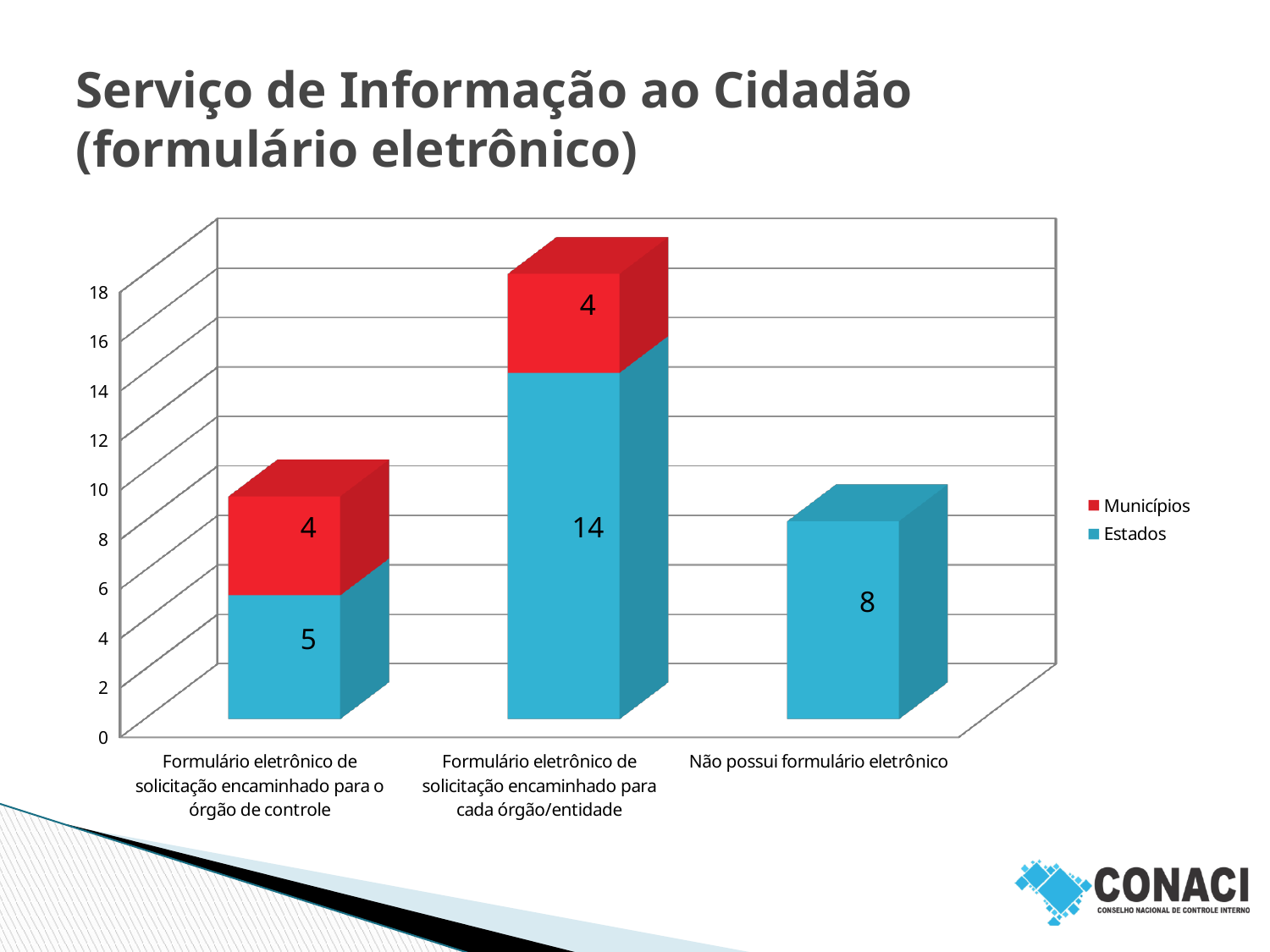
Which is larger: the Estados value for "Não possui formulário eletrônico" or the Estados value for "Formulário eletrônico de solicitação encaminhado para o órgão de controle"? Não possui formulário eletrônico What is the Estados value for "Formulário eletrônico de solicitação encaminhado para o órgão de controle"? 5 What is the total of the stacked bar for "Formulário eletrônico de solicitação encaminhado para o órgão de controle"? 9 Which category has the highest Estados value? Formulário eletrônico de solicitação encaminhado para cada órgão/entidade What is the Municípios value for "Formulário eletrônico de solicitação encaminhado para o órgão de controle"? 4 What is the total of the stacked bar for "Formulário eletrônico de solicitação encaminhado para cada órgão/entidade"? 18 Which category has the lowest Estados value? Formulário eletrônico de solicitação encaminhado para o órgão de controle What kind of chart is shown on the slide? Stacked bar chart What is the Estados value for "Não possui formulário eletrônico"? 8 What is the difference between the Estados values for "Formulário eletrônico de solicitação encaminhado para cada órgão/entidade" and "Não possui formulário eletrônico"? 6 How many series does the legend list? 2 What is the Estados value for "Formulário eletrônico de solicitação encaminhado para cada órgão/entidade"? 14